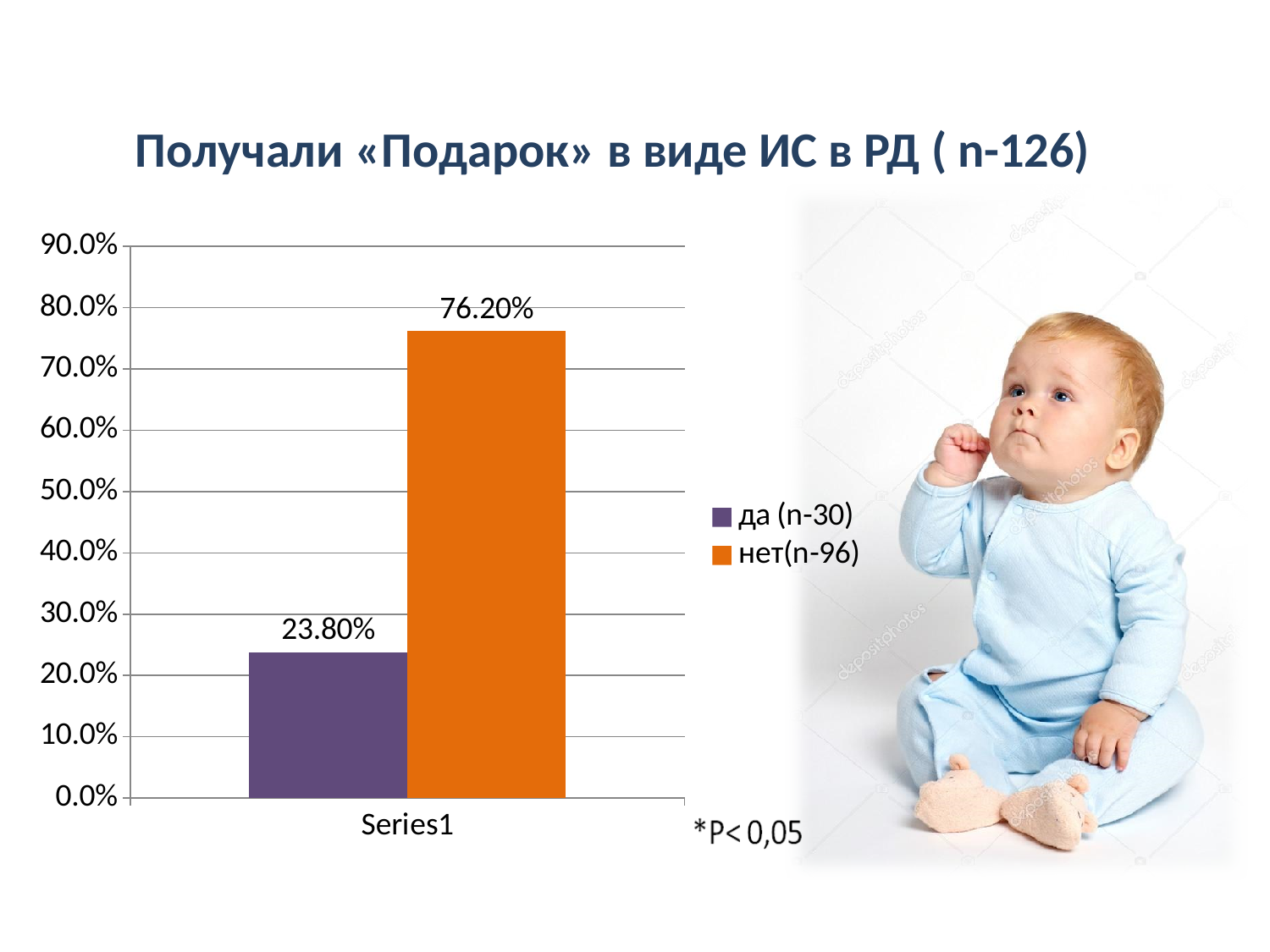
What is the difference between the values for "нет(n-96)" and "да (n-30)"? 52.40% What is the value for "нет(n-96)"? 76.20% Which series has the lowest value? да (n-30) What kind of chart is shown on the slide? bar chart What colour is the bar for "нет(n-96)"? orange What is the highest value shown on the vertical axis? 90.0% Is the value for "да (n-30)" greater or less than 30.0%? less What is the title of the chart? Получали «Подарок» в виде ИС в РД ( n-126) How many series does the legend list? 2 Which series has the higher value, "да (n-30)" or "нет(n-96)"? нет(n-96) What is the value for "да (n-30)"? 23.80% Is the value for "нет(n-96)" greater or less than 70.0%? greater